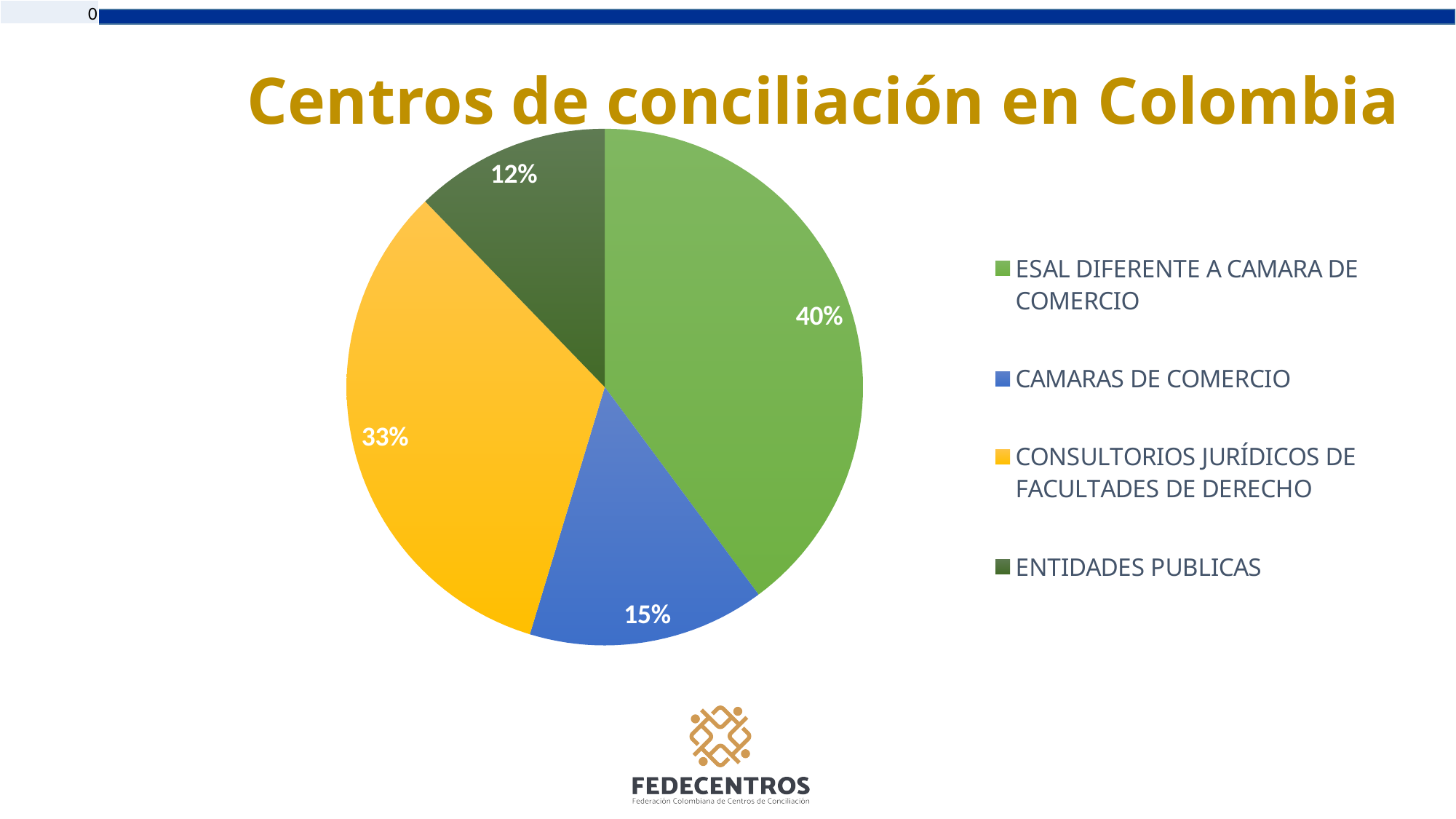
Which category has the largest share of the pie? ESAL DIFERENTE A CAMARA DE COMERCIO What percentage of the pie is CONSULTORIOS JURÍDICOS DE FACULTADES DE DERECHO? 33% Which is larger, the share for CONSULTORIOS JURÍDICOS DE FACULTADES DE DERECHO or the share for CAMARAS DE COMERCIO? CONSULTORIOS JURÍDICOS DE FACULTADES DE DERECHO What kind of chart is shown on the slide? pie chart What is the title of the chart? Centros de conciliación en Colombia What percentage of the pie is CAMARAS DE COMERCIO? 15% What is the difference in percentage points between ESAL DIFERENTE A CAMARA DE COMERCIO and CAMARAS DE COMERCIO? 25 What colour is the slice for ENTIDADES PUBLICAS? dark green How many categories does the pie chart have? 4 What percentage of the pie is ESAL DIFERENTE A CAMARA DE COMERCIO? 40% What percentage of the pie is ENTIDADES PUBLICAS? 12% Which category has the smallest share of the pie? ENTIDADES PUBLICAS